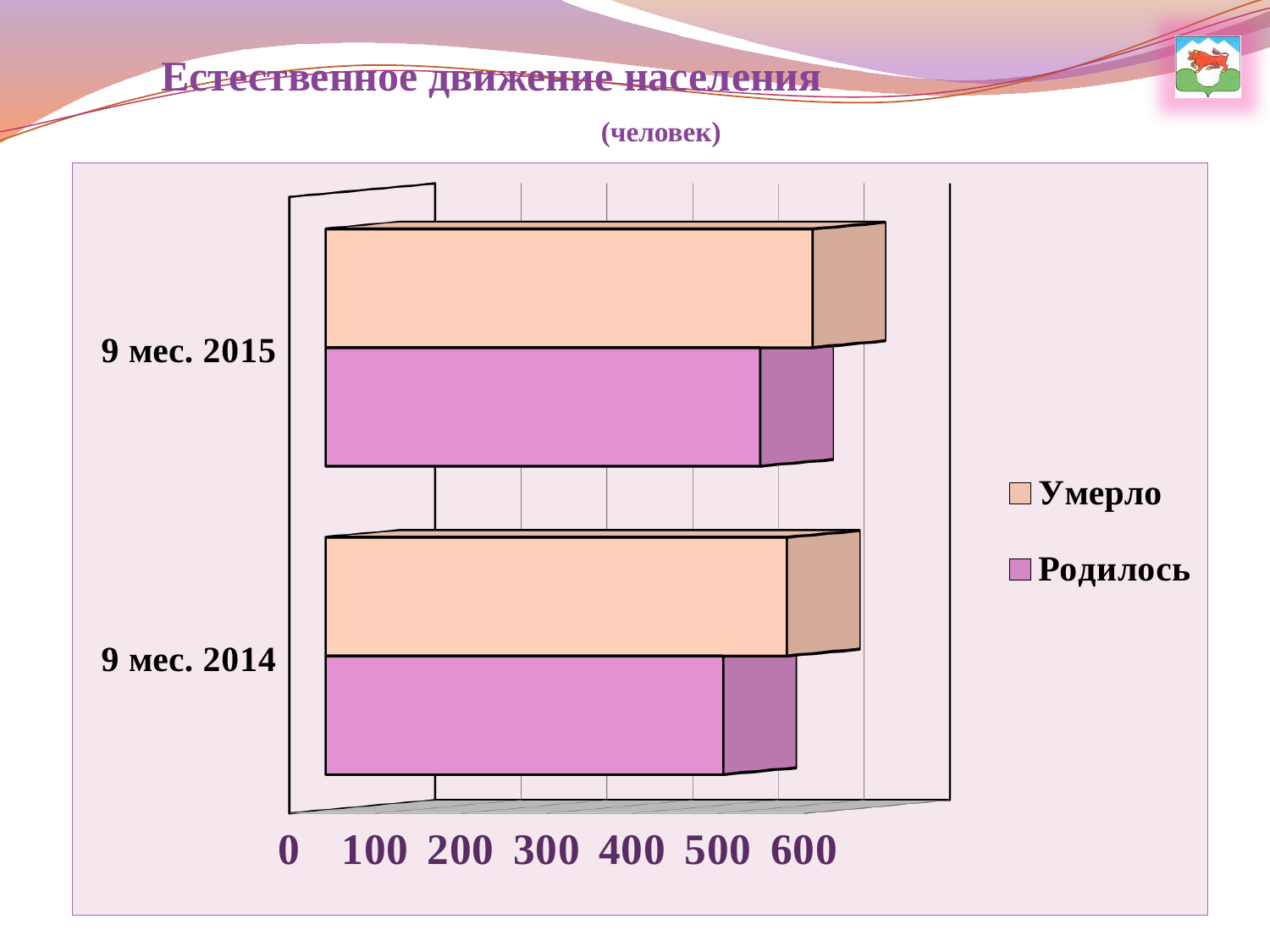
Which bar on the chart is the lowest? Родилось, 9 мес. 2014 What are the two series named in the legend? Умерло, Родилось What is the title of the chart? Естественное движение населения For 9 мес. 2014, which is larger: Умерло or Родилось? Умерло Is the value for Умерло in 9 мес. 2015 greater or less than 500? greater For 9 мес. 2015, which is larger: Умерло or Родилось? Умерло How many categories (periods) are shown on the chart? 2 What kind of chart is shown on the slide? bar chart Which period has the larger value for Родилось: 9 мес. 2014 or 9 мес. 2015? 9 мес. 2015 How many series does the legend list? 2 Is the value for Родилось in 9 мес. 2014 greater or less than 400? greater Is the value for Умерло in 9 мес. 2014 greater or less than 400? greater